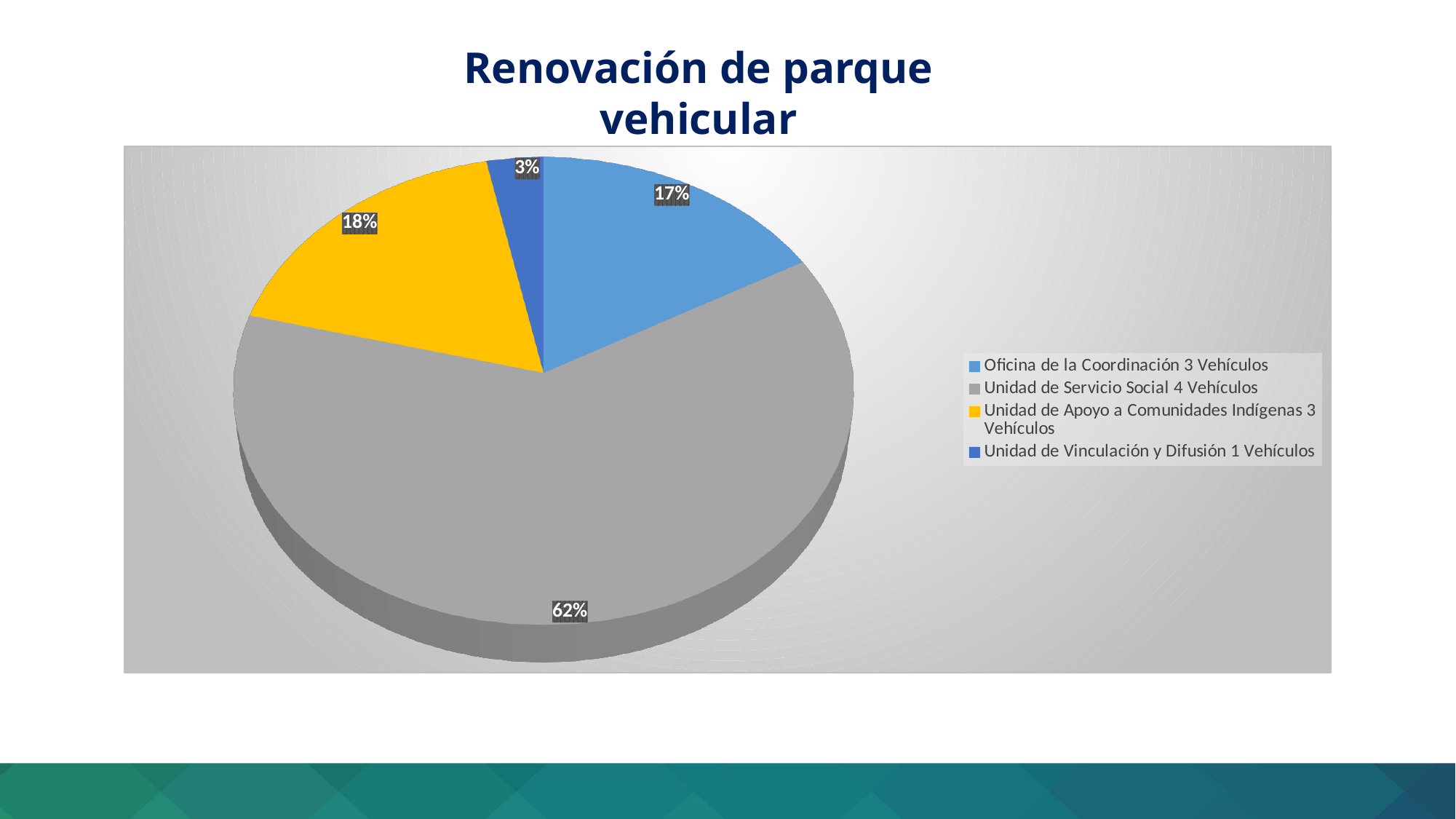
Which category has the smallest slice of the pie? Unidad de Vinculación y Difusión 1 Vehículos What percentage share does the slice for Unidad de Servicio Social 4 Vehículos have? 62% Which slice is larger: Unidad de Apoyo a Comunidades Indígenas 3 Vehículos or Unidad de Vinculación y Difusión 1 Vehículos? Unidad de Apoyo a Comunidades Indígenas 3 Vehículos What is the difference in percentage points between the Unidad de Servicio Social 4 Vehículos slice and the Oficina de la Coordinación 3 Vehículos slice? 45 What percentage share does the slice for Unidad de Apoyo a Comunidades Indígenas 3 Vehículos have? 18% What is the title of the chart? Renovación de parque vehicular What colour is the slice for Unidad de Apoyo a Comunidades Indígenas 3 Vehículos? yellow Which category has the largest slice of the pie? Unidad de Servicio Social 4 Vehículos What kind of chart is shown on the slide? pie chart What percentage share does the slice for Unidad de Vinculación y Difusión 1 Vehículos have? 3% How many categories does the pie chart show? 4